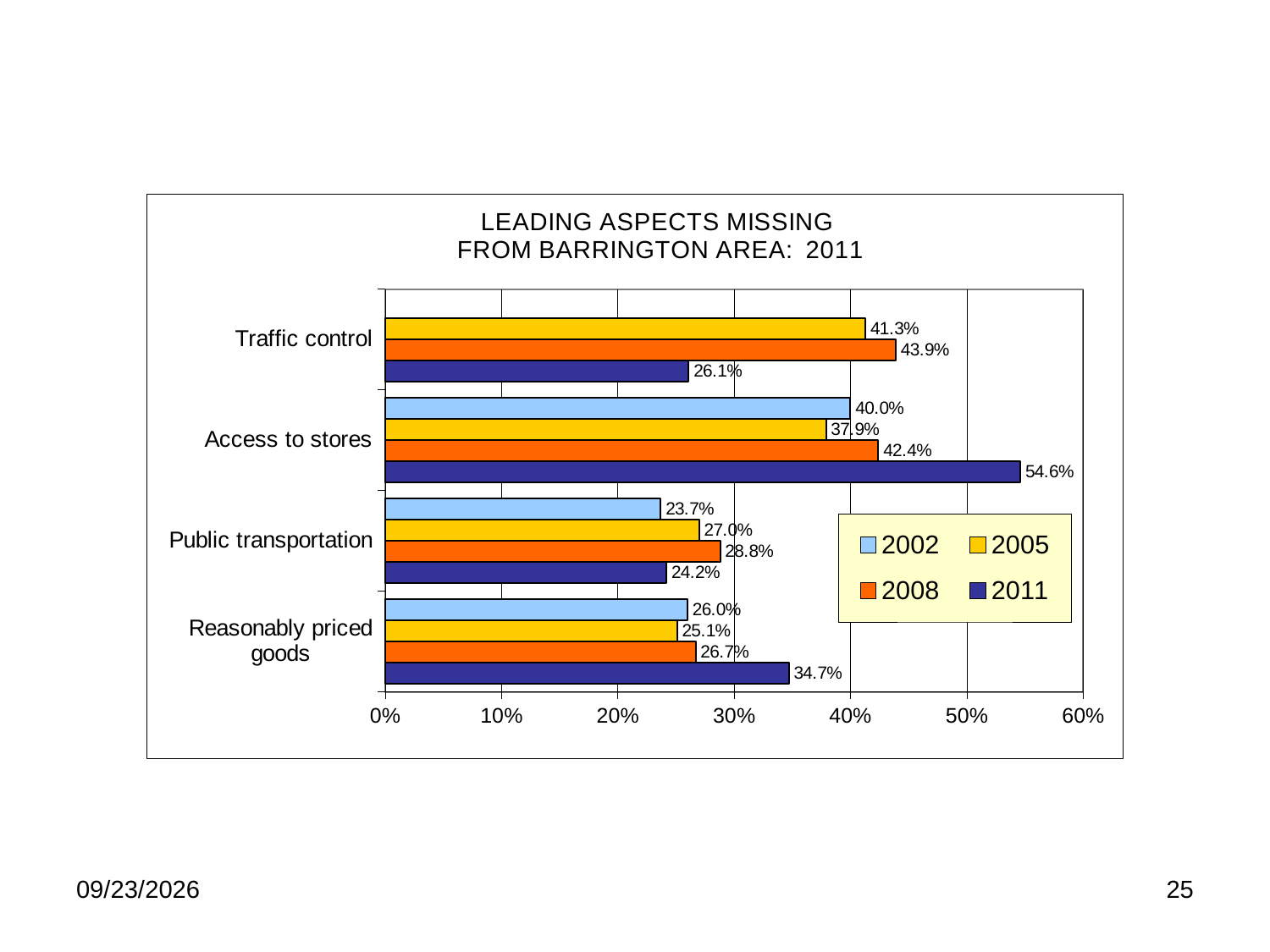
Which is larger for Traffic control: the 2005 value or the 2011 value? 2005 Which category has the lowest 2008 value? Reasonably priced goods What kind of chart is this? Bar chart How many categories are shown on the chart? 4 What is the 2005 value for Reasonably priced goods? 25.1% What is the title of the chart? LEADING ASPECTS MISSING FROM BARRINGTON AREA: 2011 What is the difference between the 2011 and 2008 values for Access to stores? 12.2% Which category has the highest 2011 value? Access to stores What is the 2008 value for Traffic control? 43.9% What is the 2002 value for Public transportation? 23.7% What is the 2011 value for Access to stores? 54.6% How many series does the legend list? 4